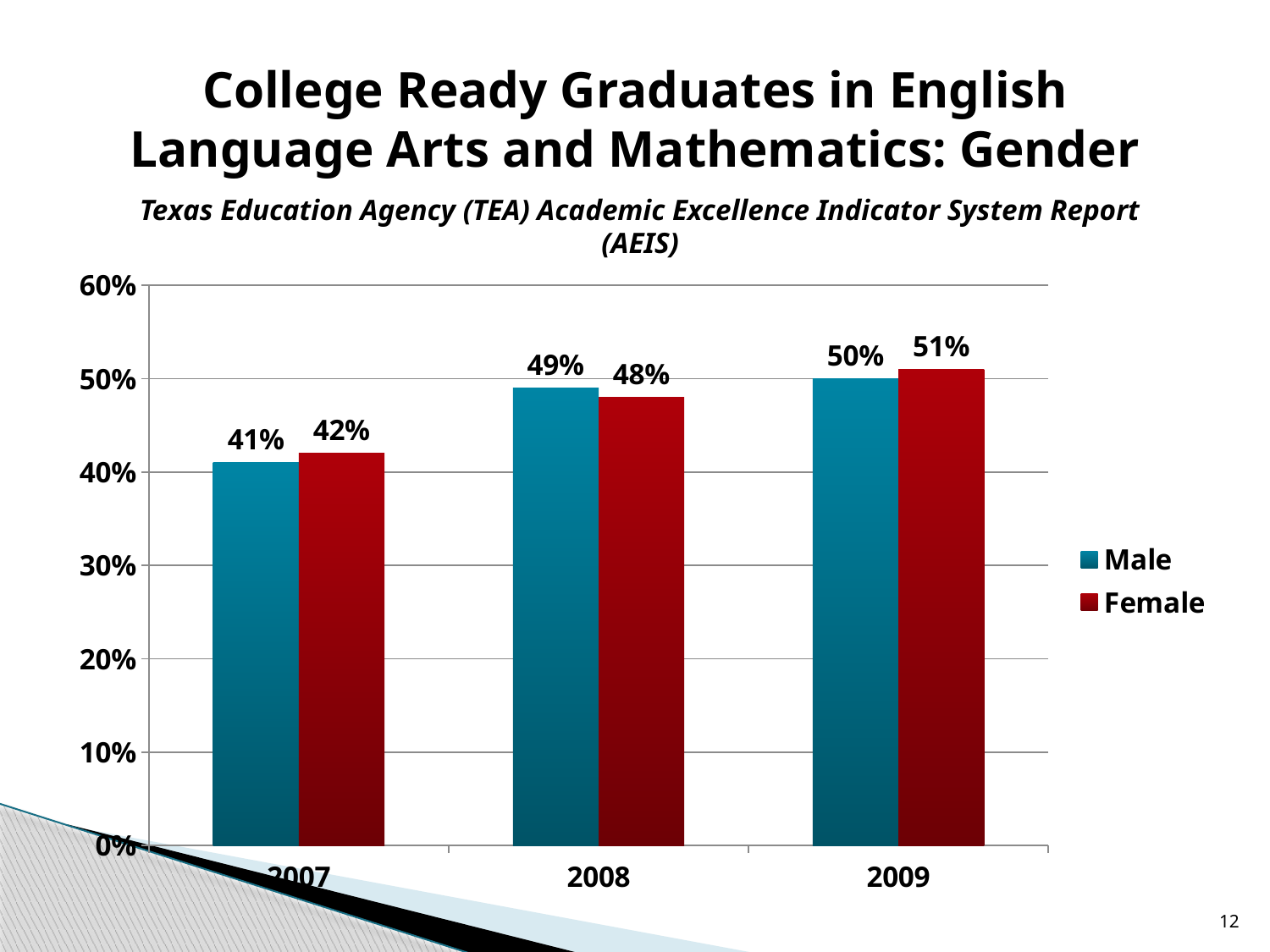
What kind of chart is shown on the slide? bar chart Is the Female value for 2007 greater or less than 50%? less In which year is the Female value lowest? 2007 What is the difference between the Male values for 2008 and 2007? 8% What is the value for Female in 2009? 51% How many years are shown on the x axis? 3 Which is larger in 2008, the Male value or the Female value? Male Do the Male values rise or fall from 2007 to 2009? rise What is the value for Male in 2007? 41% What is the value for Female in 2008? 48% How many series does the legend list? 2 In which year is the Male value highest? 2009